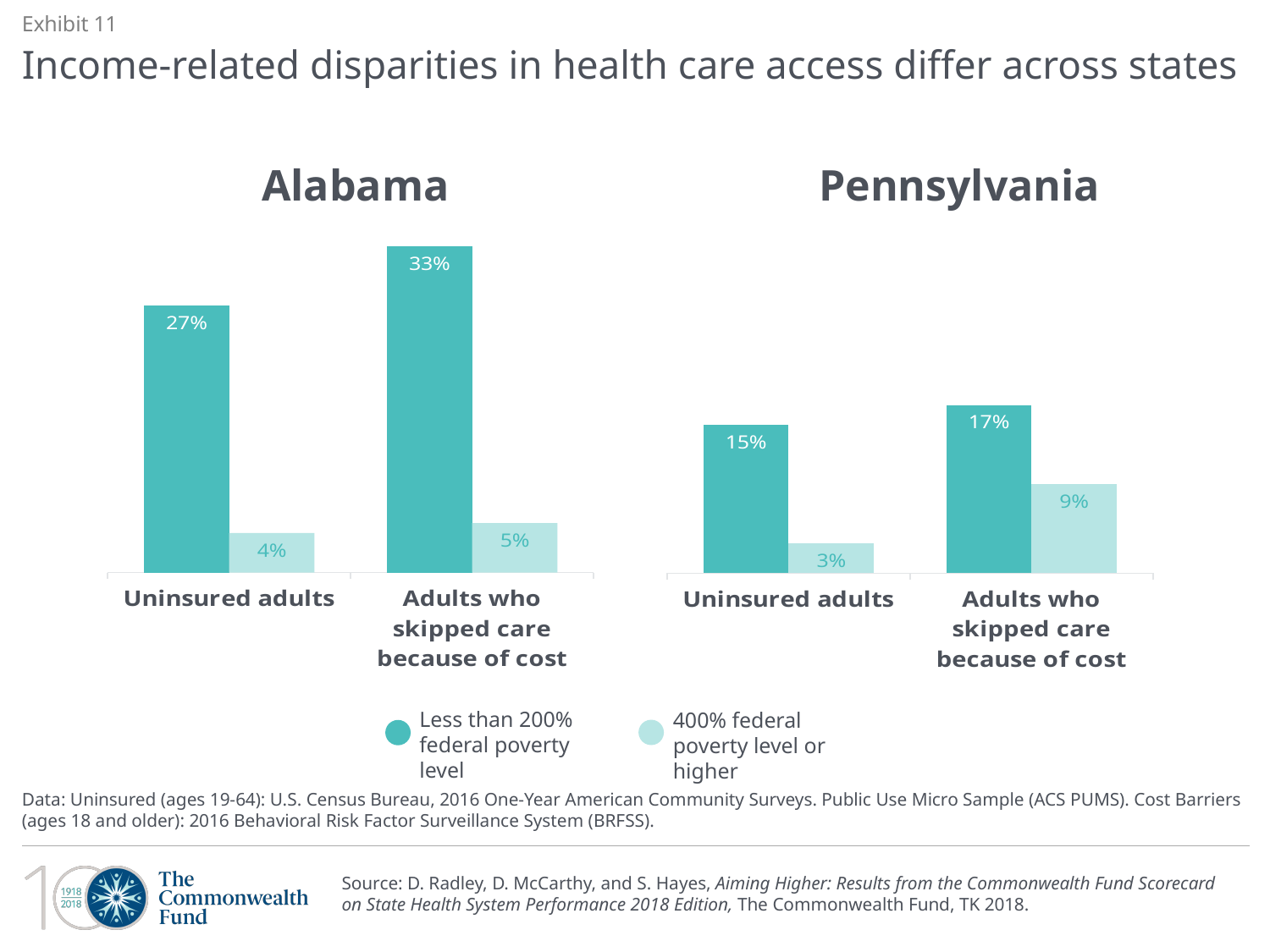
In the Pennsylvania chart, what is the difference between the two income groups for adults who skipped care because of cost? 8 percentage points In the Alabama chart, which category has the highest value for the less than 200% federal poverty level series? Adults who skipped care because of cost Which is larger: the uninsured rate for adults below 200% of the federal poverty level in Alabama or in Pennsylvania? Alabama In the Alabama chart, what is the value for uninsured adults with income less than 200% of the federal poverty level? 27% In the Alabama chart, what is the value for adults who skipped care because of cost with income less than 200% of the federal poverty level? 33% What type of chart is used for Alabama and Pennsylvania? Bar chart In the Pennsylvania chart, which bar has the lowest value? Uninsured adults, 400% federal poverty level or higher How many series does the legend list? 2 In the Pennsylvania chart, what is the value for uninsured adults with income at 400% of the federal poverty level or higher? 3% In the Pennsylvania chart, what is the value for adults who skipped care because of cost with income at 400% of the federal poverty level or higher? 9% How many categories are shown on the x axis of the Pennsylvania chart? 2 In the Alabama chart, what is the difference between the two income groups for uninsured adults? 23 percentage points